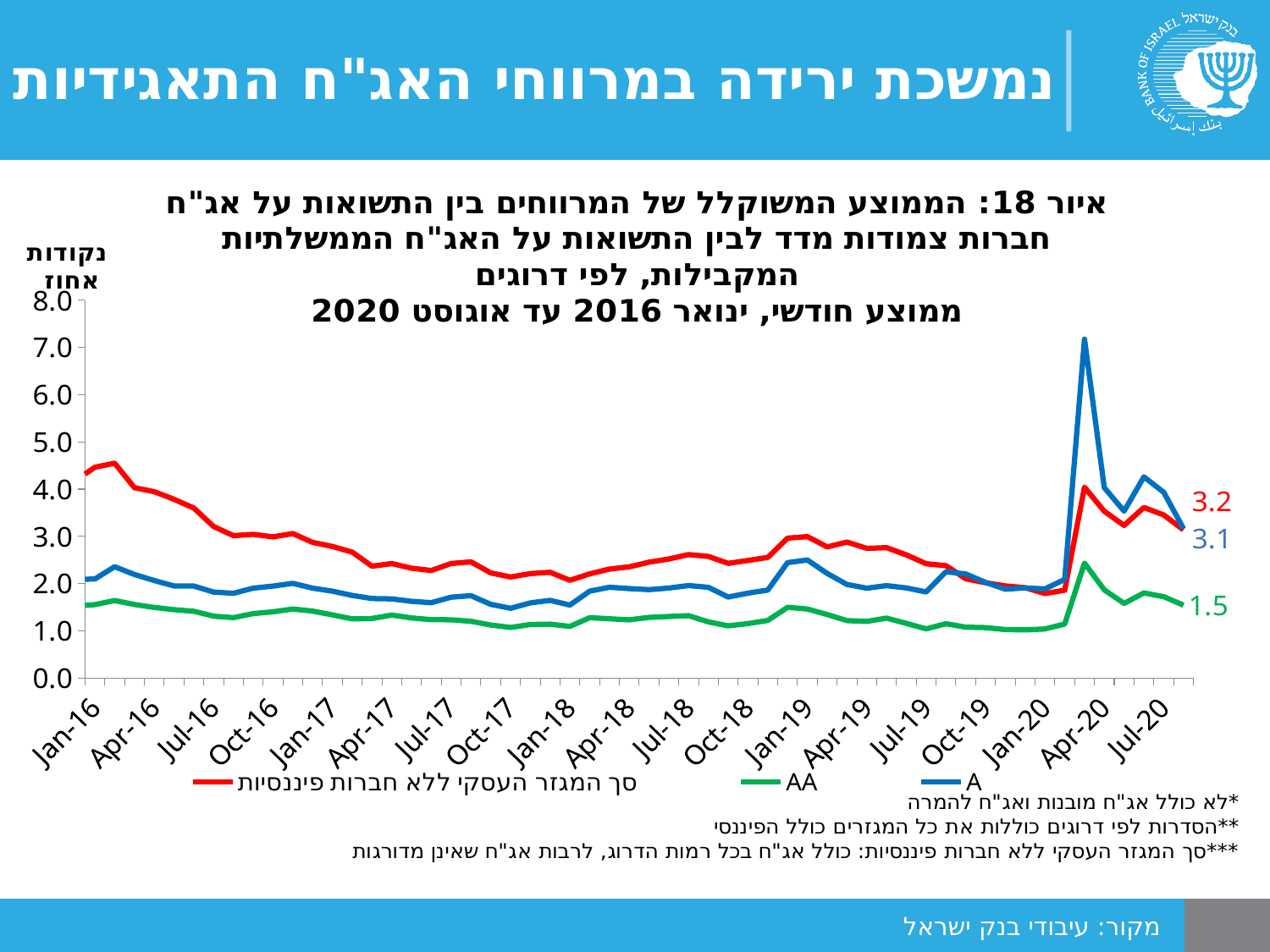
What is the difference between the final values of the סך המגזר העסקי ללא חברות פיננסיות series and the AA series? 1.7 Is the peak value of the A series around Apr-20 greater or less than 6.0? greater What is the difference between the final values of the A series and the AA series? 1.6 How many series does the legend list? 3 What is the final value shown for the A series? 3.1 Does the סך המגזר העסקי ללא חברות פיננסיות series rise or fall from Jan-16 to Jan-18? fall Which series reaches the highest peak on the chart? A What is the final value shown for the AA series? 1.5 Is the value of the AA series at Jan-16 greater or less than 2.0? less What is the final value shown for the series סך המגזר העסקי ללא חברות פיננסיות? 3.2 Which series has the lowest value at the end of the period? AA What kind of chart is shown on the slide? line chart